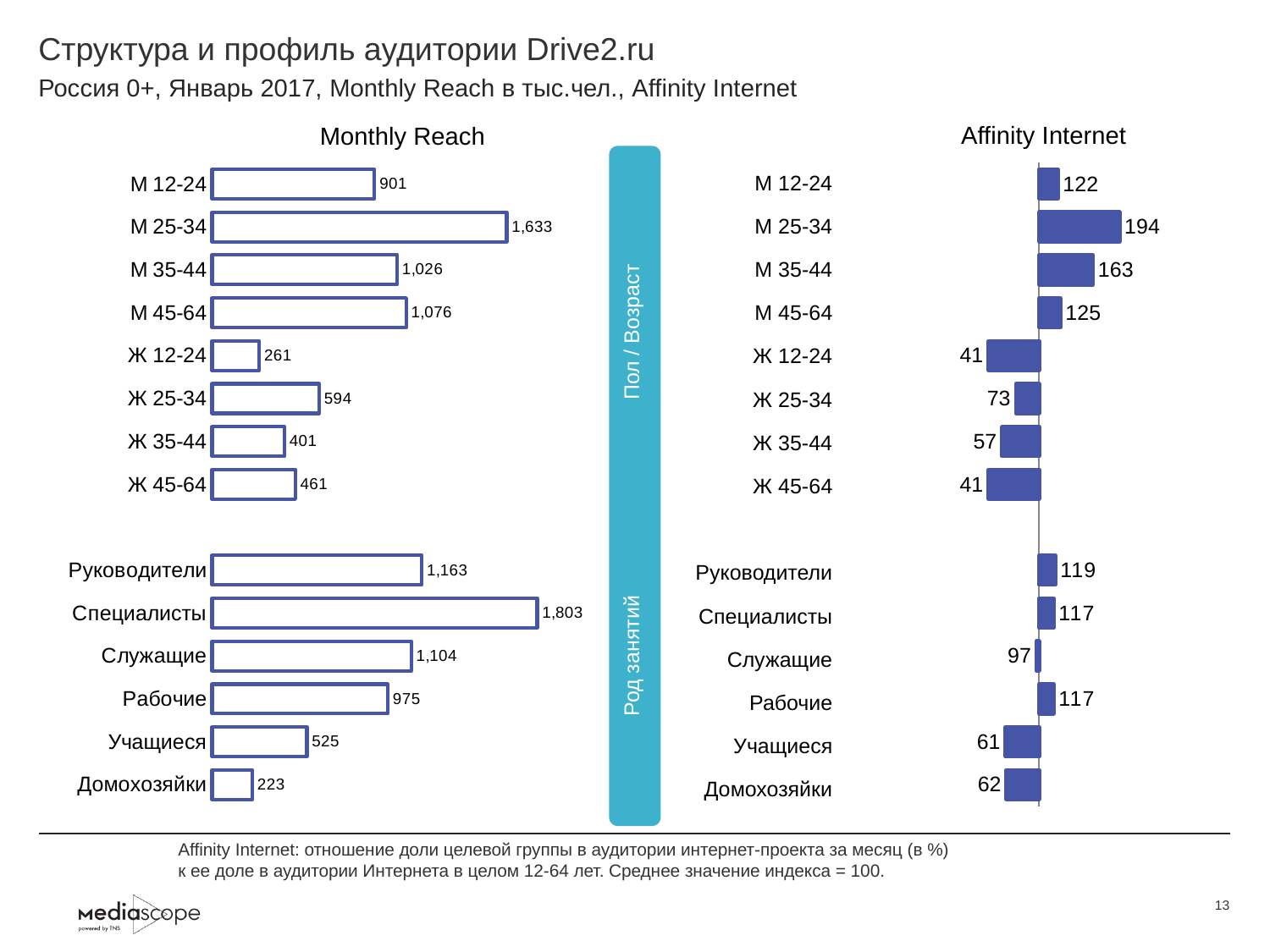
In the Affinity Internet chart, which category has the highest value? М 25-34 In the Monthly Reach chart, what is the difference between Специалисты and Руководители? 640 What kind of chart is the Affinity Internet chart? Bar chart In the Affinity Internet chart, what is the difference between М 35-44 and М 45-64? 38 In the Affinity Internet chart, what is the value for Ж 25-34? 73 How many categories are shown in the Monthly Reach chart? 14 In the Monthly Reach chart, which is larger: М 35-44 or М 45-64? М 45-64 In the Affinity Internet chart, what is the value for Служащие? 97 In the Monthly Reach chart, what is the value for М 25-34? 1,633 In the Monthly Reach chart, what is the value for Домохозяйки? 223 In the Monthly Reach chart, which category has the lowest value? Домохозяйки In the Affinity Internet chart, which is larger: Учащиеся or Домохозяйки? Домохозяйки